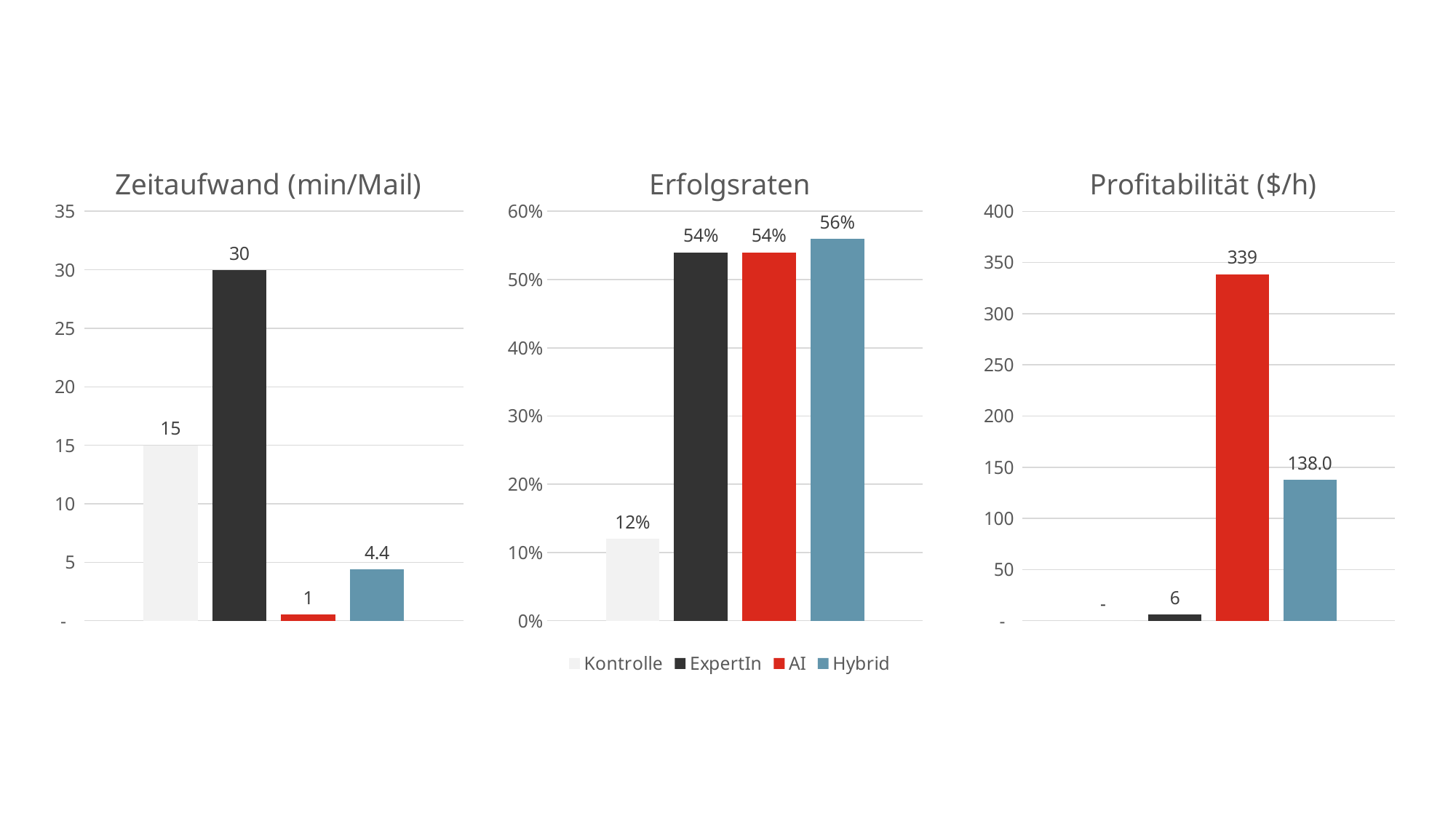
In the 'Erfolgsraten' chart, what is the value for Kontrolle? 12% In the 'Zeitaufwand (min/Mail)' chart, what is the value for ExpertIn? 30 In the 'Profitabilität ($/h)' chart, which is larger, the value for ExpertIn or the value for Hybrid? Hybrid In the 'Profitabilität ($/h)' chart, what is the value for Hybrid? 138.0 In the 'Erfolgsraten' chart, what is the difference between the Hybrid and Kontrolle values? 44% In the 'Zeitaufwand (min/Mail)' chart, which series has the lowest value? AI How many series does the legend list? 4 In the 'Zeitaufwand (min/Mail)' chart, what is the difference between the Kontrolle and ExpertIn values? 15 In the 'Profitabilität ($/h)' chart, what is the value for AI? 339 What kind of chart is the 'Erfolgsraten' chart? Bar chart In the 'Erfolgsraten' chart, which series has the highest value? Hybrid In the 'Zeitaufwand (min/Mail)' chart, what is the value for Hybrid? 4.4